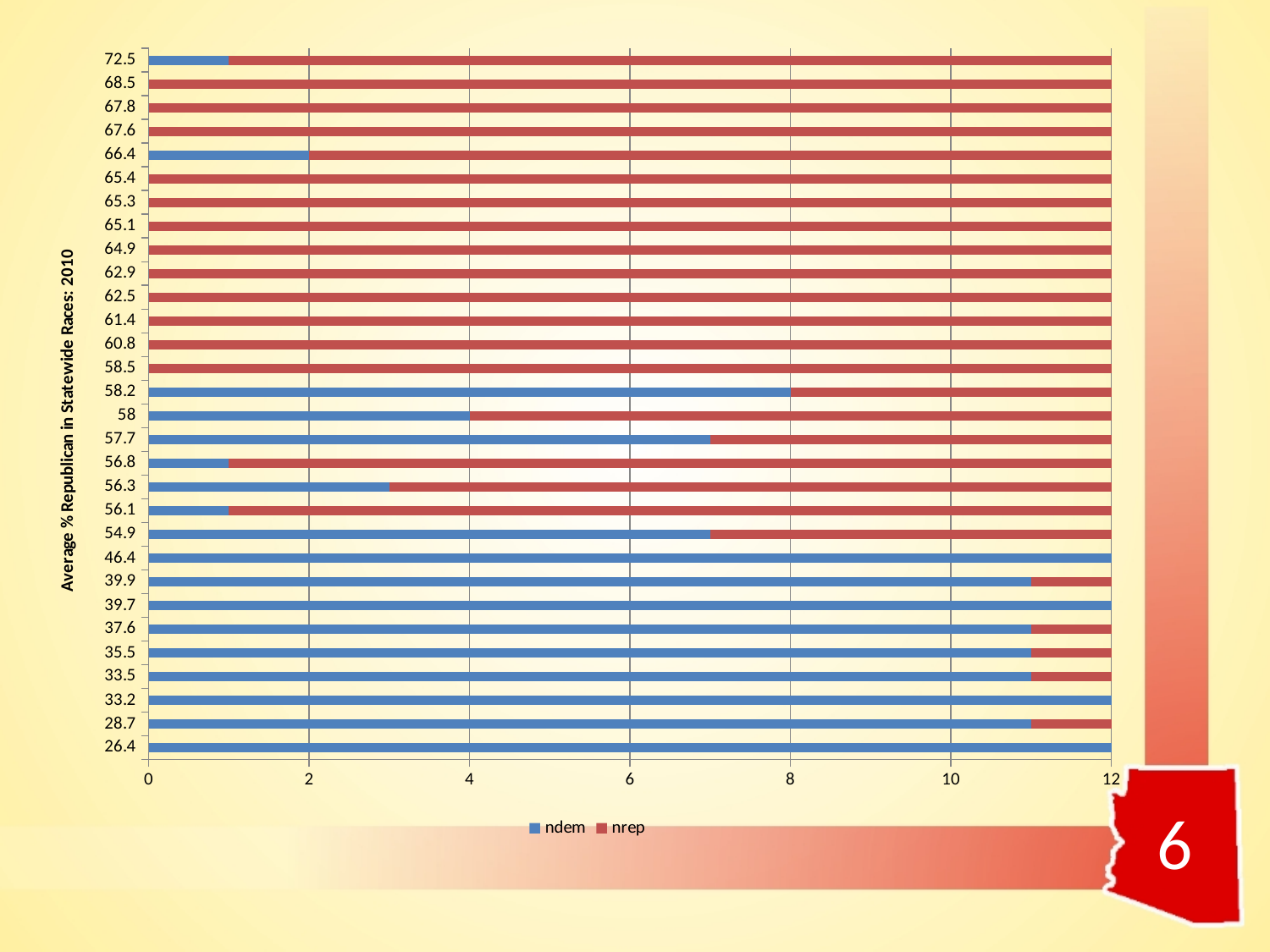
Is the nrep value for the 39.9 category greater or less than 2? less What is the ndem value for the 66.4 category? 2 What kind of chart is shown on the slide? bar chart What is the total of the stacked bar for the 68.5 category? 12 What is the ndem value for the 58 category? 4 How many series does the legend list? 2 What are the names of the two series in the legend? ndem and nrep Is the ndem value for the 57.7 category greater or less than 6? greater Which has the larger ndem value, the 58.2 category or the 58 category? 58.2 What is the ndem value for the 58.2 category? 8 What is the y-axis title of the chart? Average % Republican in Statewide Races: 2010 How many categories are plotted on the y axis? 30